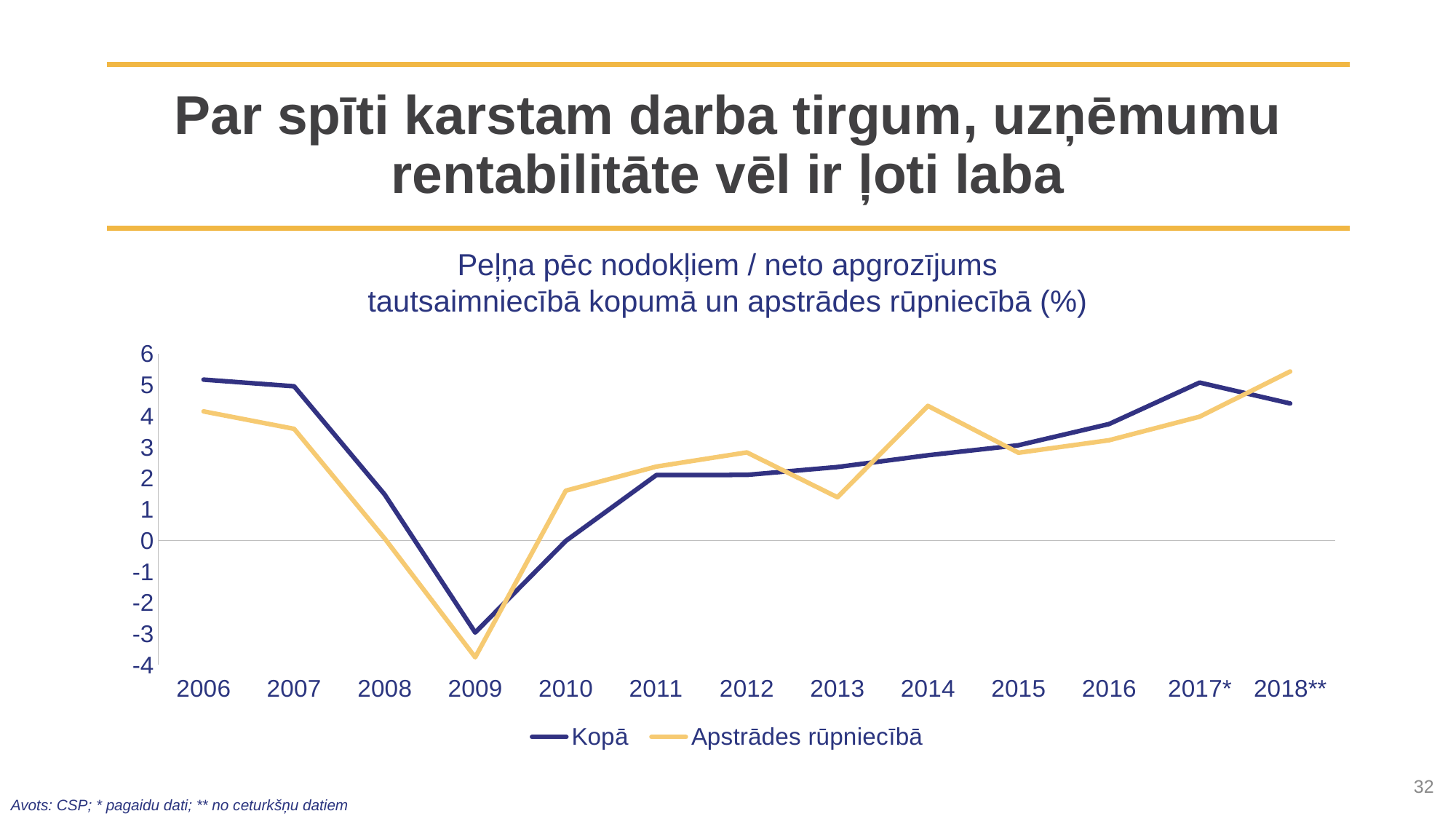
Which colour is used for the Apstrādes rūpniecībā line? yellow Is the value for Apstrādes rūpniecībā in 2009 greater or less than -3? less In which year does the Apstrādes rūpniecībā series reach its highest value? 2018** Which series has the higher value in 2006, Kopā or Apstrādes rūpniecībā? Kopā What kind of chart is shown on the slide? line chart How many years are shown on the x axis? 13 Do the values of the Kopā series rise or fall from 2006 to 2009? fall Is the value for Kopā in 2006 greater or less than 5? greater In which year does the Apstrādes rūpniecībā series reach its lowest value? 2009 In which year does the Kopā series reach its lowest value? 2009 How many series does the legend list? 2 Which series has the higher value in 2014, Kopā or Apstrādes rūpniecībā? Apstrādes rūpniecībā